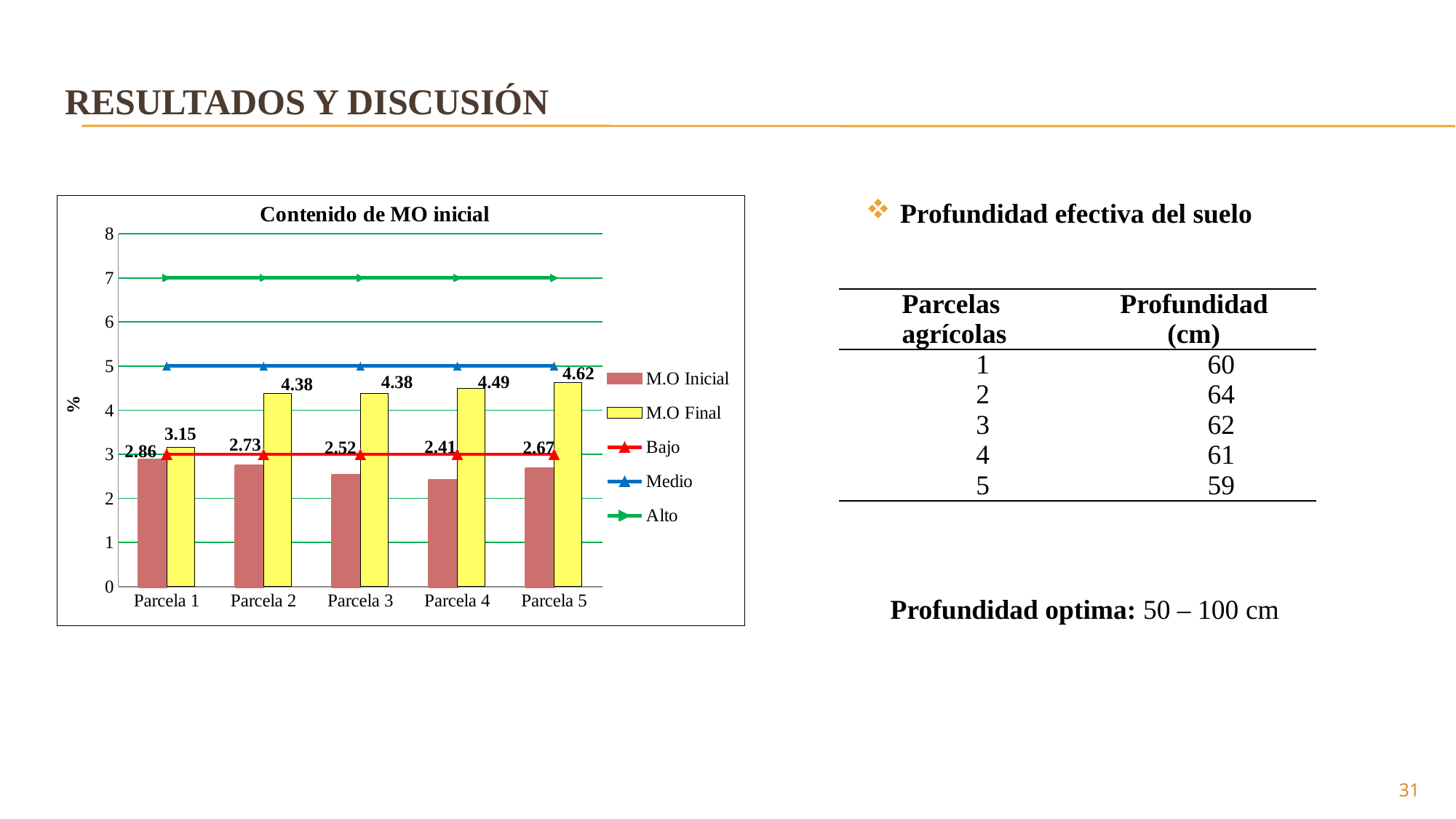
What is the M.O Final value for Parcela 1? 3.15 What is the difference between the M.O Final and M.O Inicial values for Parcela 4? 2.08 Is the M.O Final value for Parcela 2 greater or less than 4? greater How many parcelas are shown on the x axis of the chart? 5 How many series does the chart legend list? 5 Which is larger, the M.O Inicial value for Parcela 1 or for Parcela 2? Parcela 1 What is the M.O Final value for Parcela 5? 4.62 What is the title of the chart? Contenido de MO inicial What kind of chart is used to show the M.O Inicial and M.O Final values? Bar chart Which parcela has the lowest M.O Inicial value? Parcela 4 Which parcela has the highest M.O Final value? Parcela 5 What is the M.O Inicial value for Parcela 3? 2.52